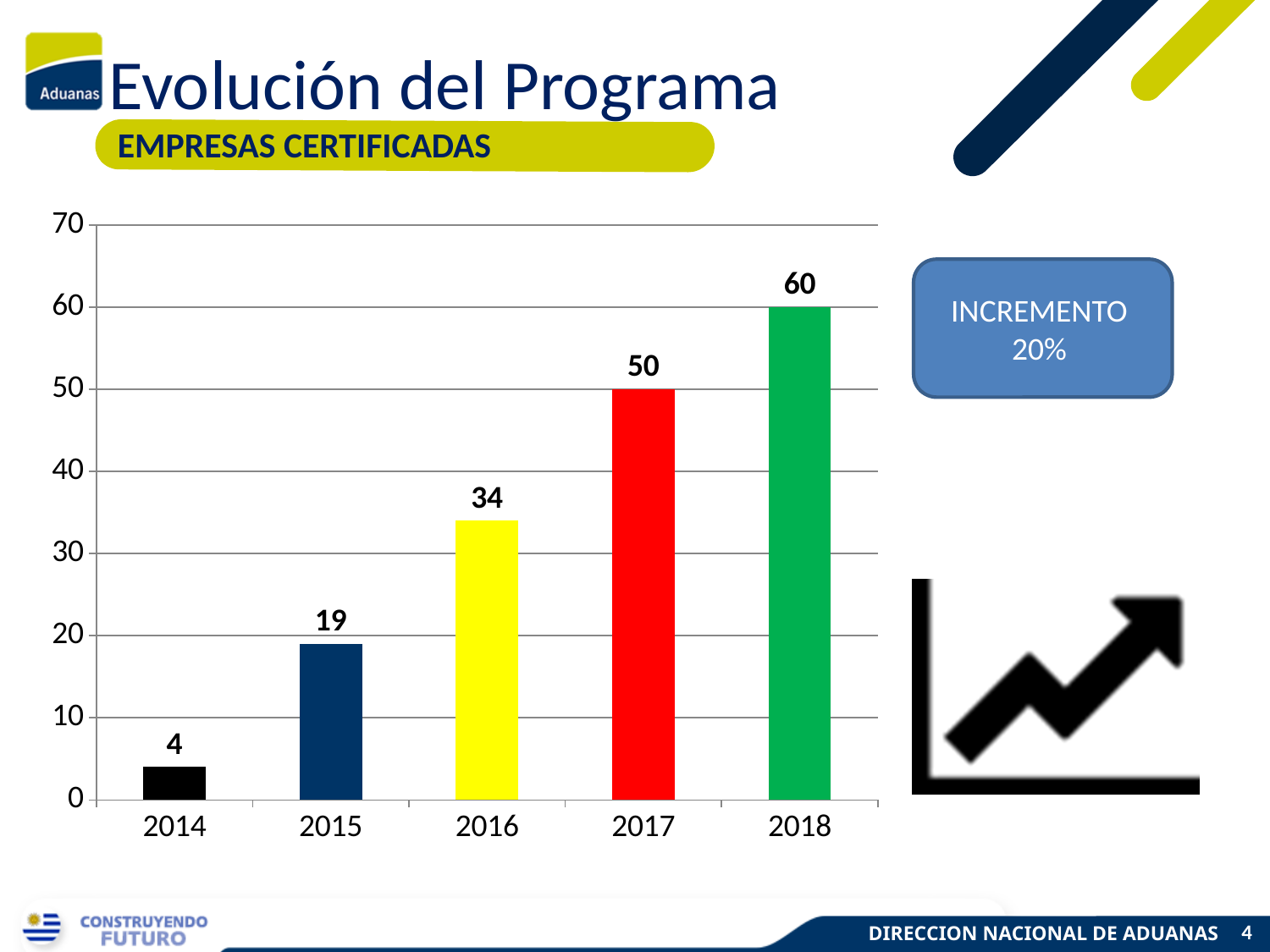
Which year has the lowest value? 2014 Do the values rise or fall from 2014 to 2018? rise What is the value for 2016? 34 What is the difference between the values for 2017 and 2015? 31 Which is larger, the value for 2015 or the value for 2016? 2016 What is the value for 2014? 4 What colour is the bar for 2017? red Which year has the highest value? 2018 How many years are shown on the x axis? 5 What kind of chart is this? bar chart What is the difference between the values for 2018 and 2017? 10 What is the value for 2018? 60